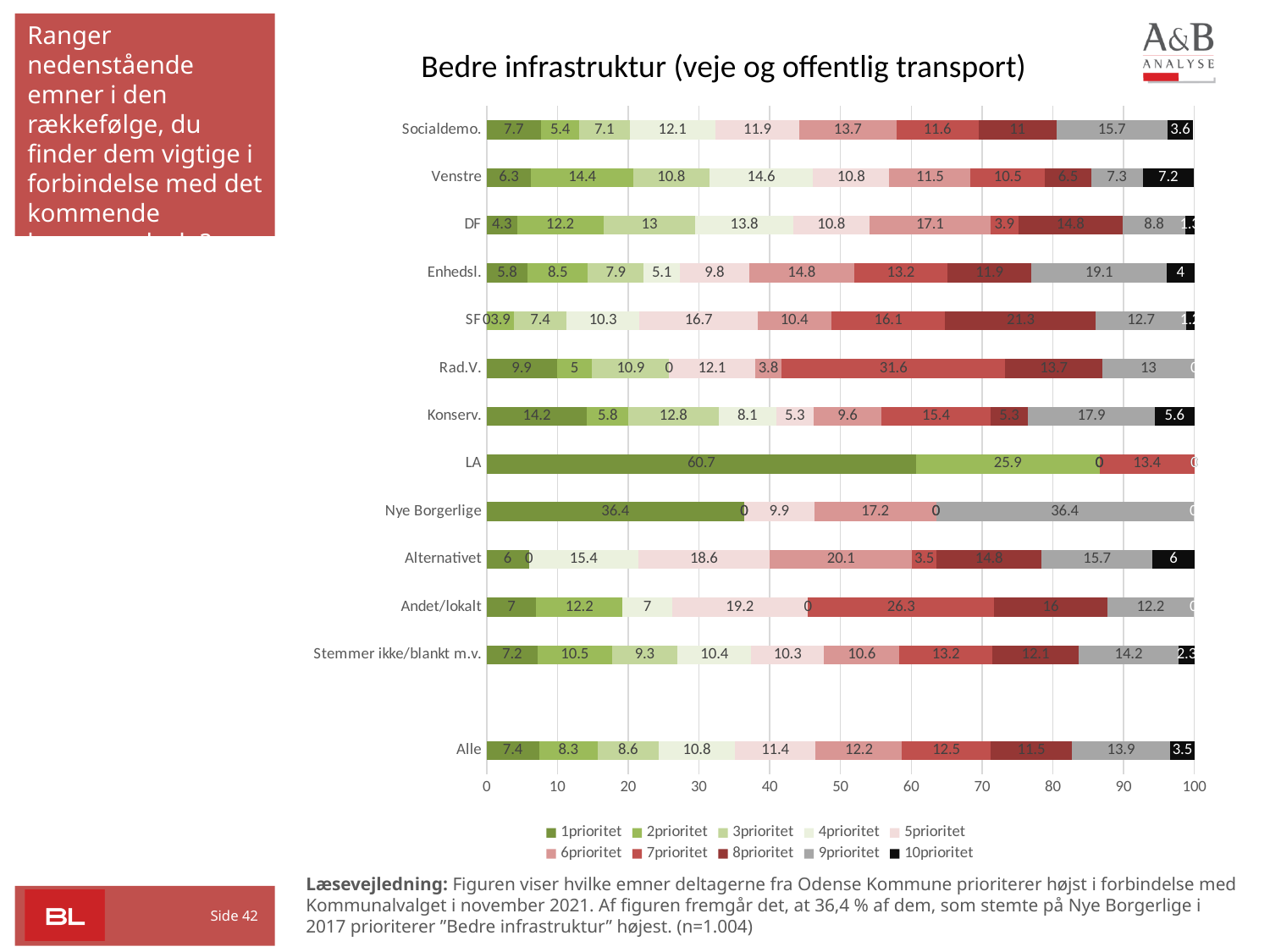
What type of chart is shown on the slide? Stacked bar chart What is the 1prioritet value for Alle? 7.4 What is the 9prioritet value for Enhedsl.? 19.1 How many series does the legend list? 10 What is the 1prioritet value for Nye Borgerlige? 36.4 What is the title of the chart? Bedre infrastruktur (veje og offentlig transport) What is the 1prioritet value for LA? 60.7 Which category has the highest 1prioritet value? LA How many categories are shown on the vertical axis of the chart? 13 What is the 7prioritet value for Rad.V.? 31.6 Which has the larger 1prioritet value, Konserv. or Socialdemo.? Konserv. What is the difference between the 1prioritet values for LA and Nye Borgerlige? 24.3